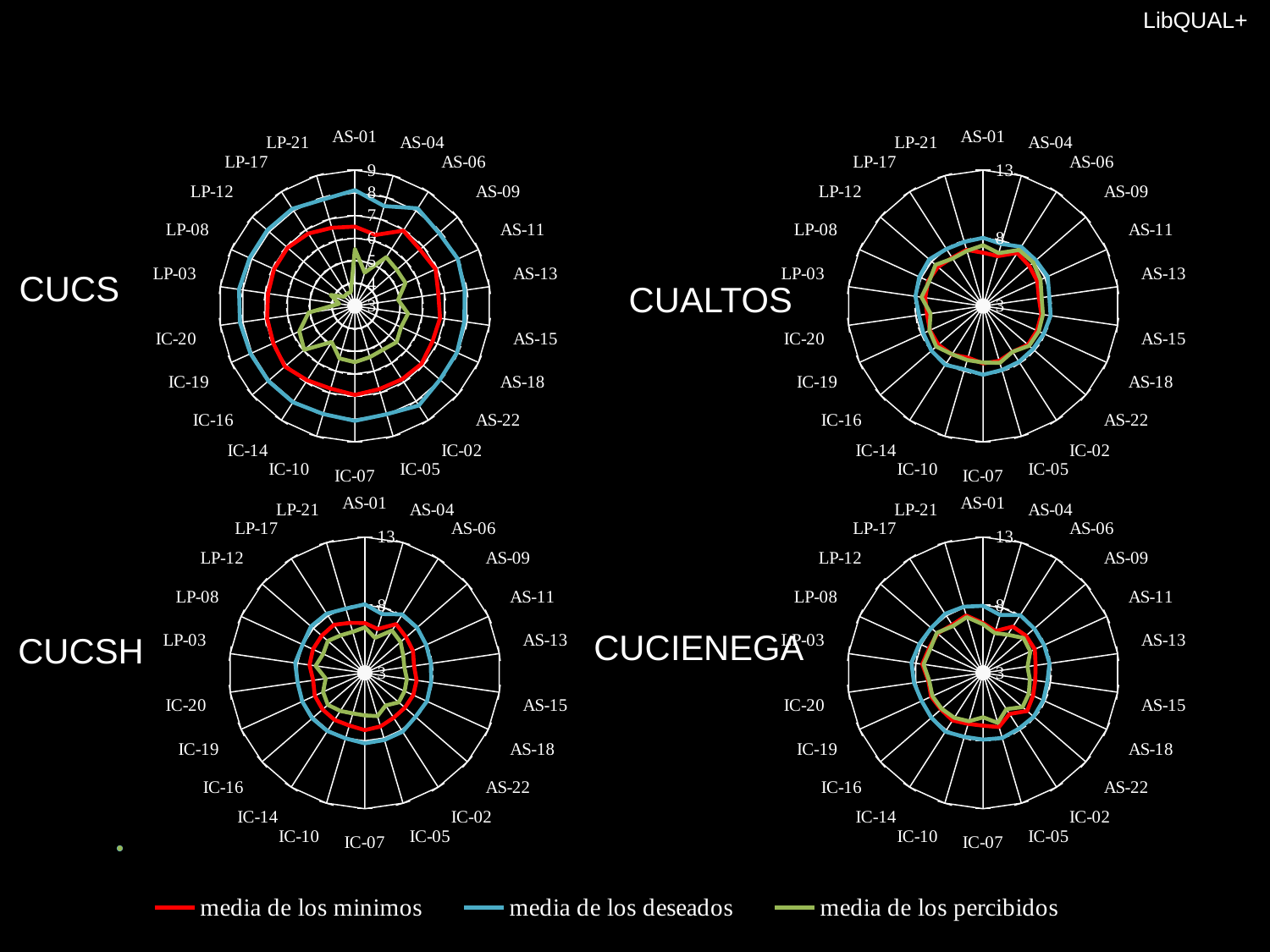
What kind of chart is used for the CUCS data? radar chart How many radar charts are shown on the slide? 4 How many series does the legend at the bottom of the slide list? 3 Which colour represents 'media de los deseados' in the legend? blue In the CUCS chart, which series has the larger value at LP-03, media de los minimos or media de los percibidos? media de los minimos How many categories are plotted around the CUCSH radar chart? 22 In the CUCS chart, is the value of media de los percibidos at AS-01 greater or less than 7? less In the CUCS chart, is the value of media de los deseados at AS-01 greater or less than 5? greater In the CUALTOS chart, is the value of media de los deseados at AS-01 greater or less than 13? less In the CUCSH chart, which series has the larger value at AS-15, media de los deseados or media de los minimos? media de los deseados In the CUCS chart, which series has the larger value at IC-07, media de los deseados or media de los percibidos? media de los deseados